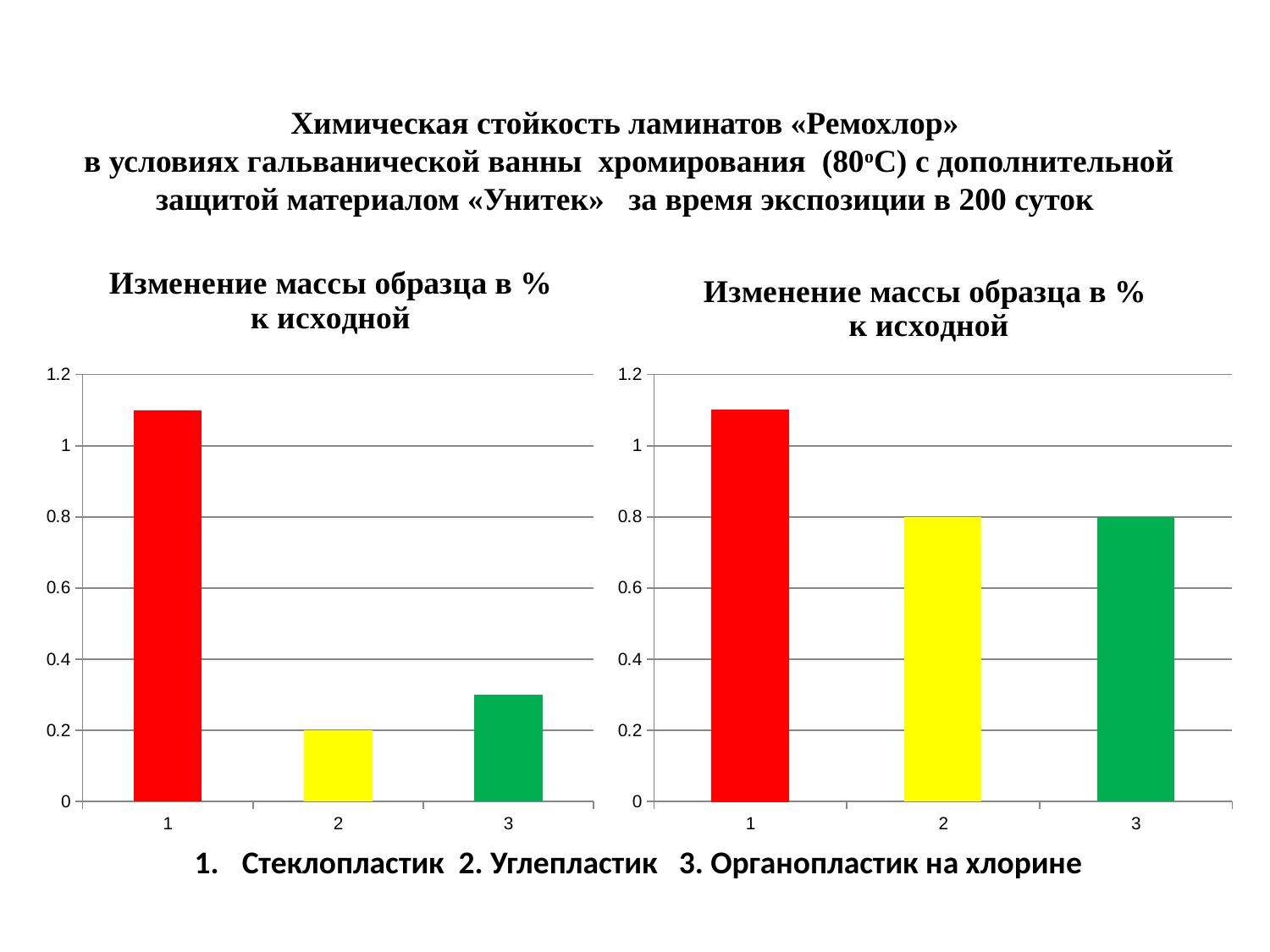
In the right chart, what is the difference between the values for category 2 and category 3? 0 What type of chart is the right chart? bar chart In the right chart, which category has the highest value? 1 In the left chart, what is the value for category 2? 0.2 In the right chart, what is the value for category 2? 0.8 In the left chart, which category has the highest value? 1 In the right chart, is the value for category 1 greater or less than 1? greater In the left chart, is the value for category 3 greater or less than 0.4? less In the right chart, what is the value for category 3? 0.8 How many categories are shown in the left chart? 3 In the left chart, which category has the lowest value? 2 In the left chart, is the value for category 1 greater or less than 1? greater